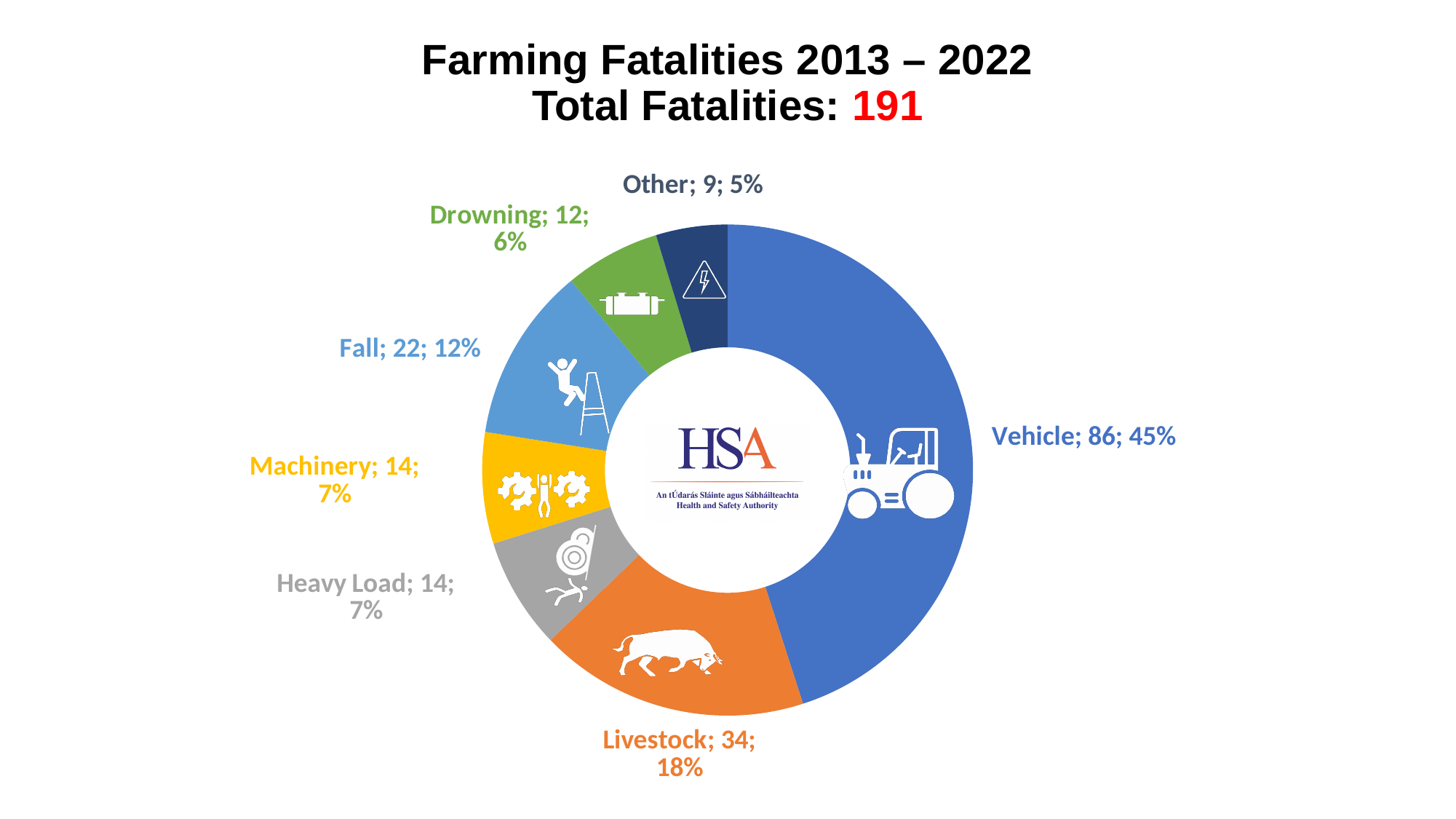
Which category accounts for the fewest fatalities? Other Which category accounts for the most fatalities? Vehicle What total number of fatalities is stated in the chart title? 191 What share of fatalities does the Livestock slice represent? 18% What is the difference between the Vehicle and Livestock fatality counts? 52 How many fatalities were caused by Livestock? 34 How many farming fatalities were attributed to Vehicle? 86 Which has more fatalities, Fall or Machinery? Fall What kind of chart is shown on the slide? Doughnut chart How many fatalities are shown for Drowning? 12 What share of fatalities does the Fall slice represent? 12% How many categories does the pie chart show? 7